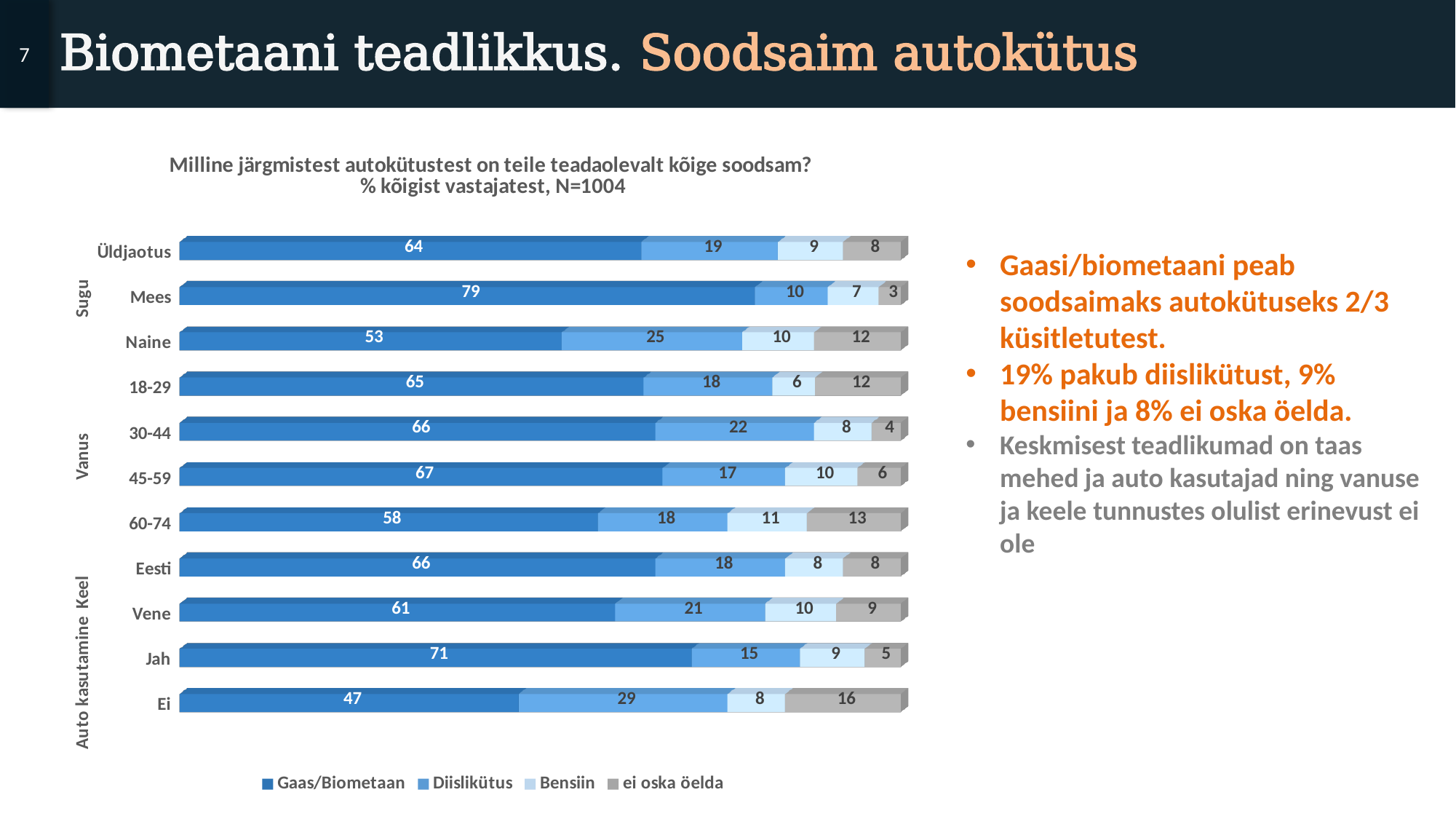
Which category has the lowest 'ei oska öelda' value? Mees Which is larger, the Diislikütus value for Ei or for Jah? Ei What is the Diislikütus value for Naine? 25 What is the difference between the Gaas/Biometaan values for Mees and Naine? 26 Which category has the lowest Gaas/Biometaan value? Ei What is the Gaas/Biometaan value for Üldjaotus? 64 What is the total of the stacked bar for Mees? 99 How many categories are plotted on the chart? 11 What is the 'ei oska öelda' value for 60-74? 13 How many series does the legend list? 4 What kind of chart is shown on the slide? Stacked bar chart Which category has the highest Gaas/Biometaan value? Mees